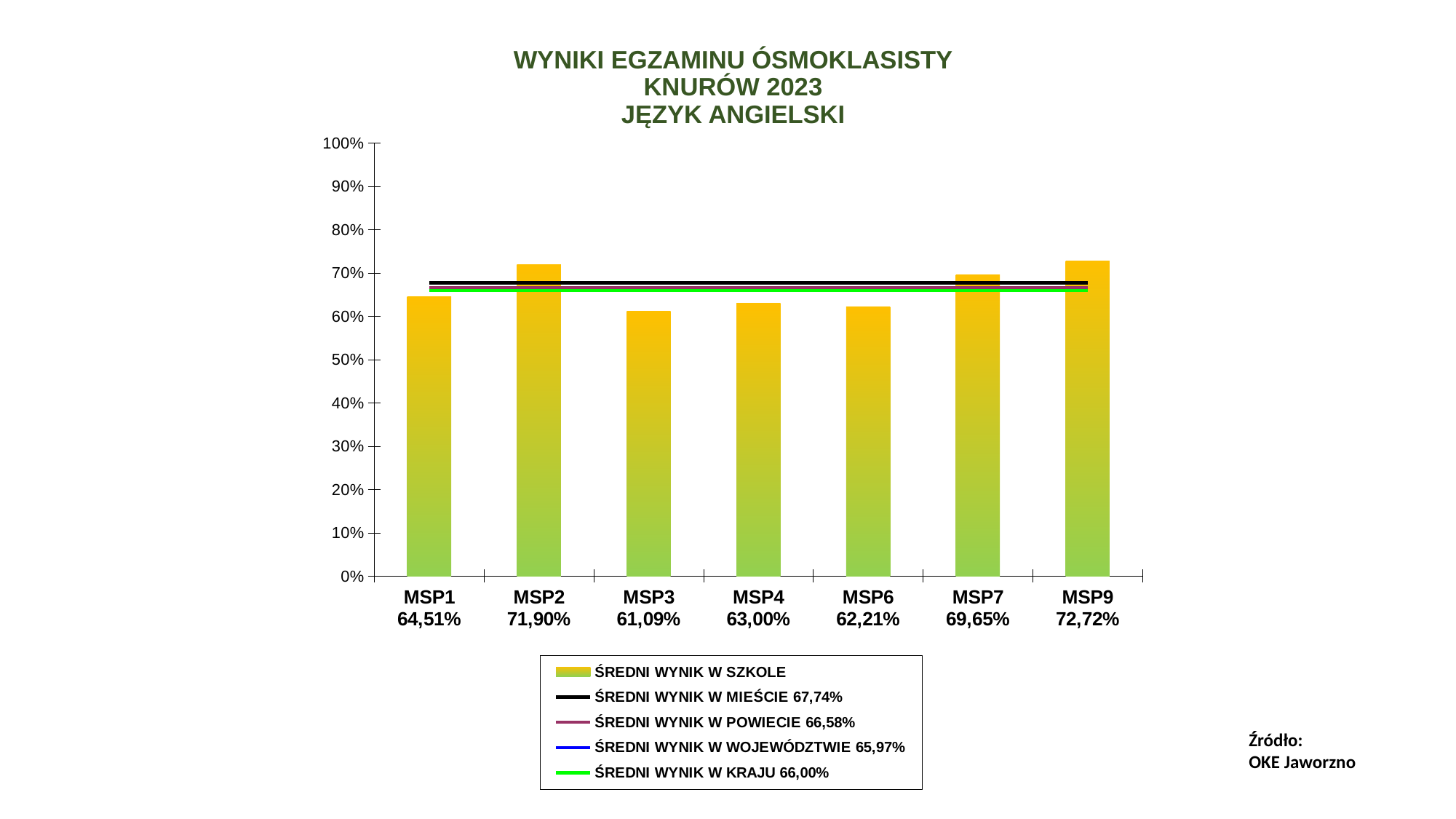
How many series does the legend list? 5 Is the value for MSP4 greater or less than 70%? less What is the average school result for MSP2? 71,90% Which school has a higher result, MSP1 or MSP7? MSP7 Which school has the highest average result? MSP9 How many schools are shown on the x axis? 7 Which school has the lowest average result? MSP3 What is the difference between the results of MSP9 and MSP3? 11,63% What kind of chart is shown on the slide? combination bar and line chart What is the average result in the city (ŚREDNI WYNIK W MIEŚCIE) according to the legend? 67,74% What is the average school result for MSP6? 62,21% What is the source given on the slide? OKE Jaworzno